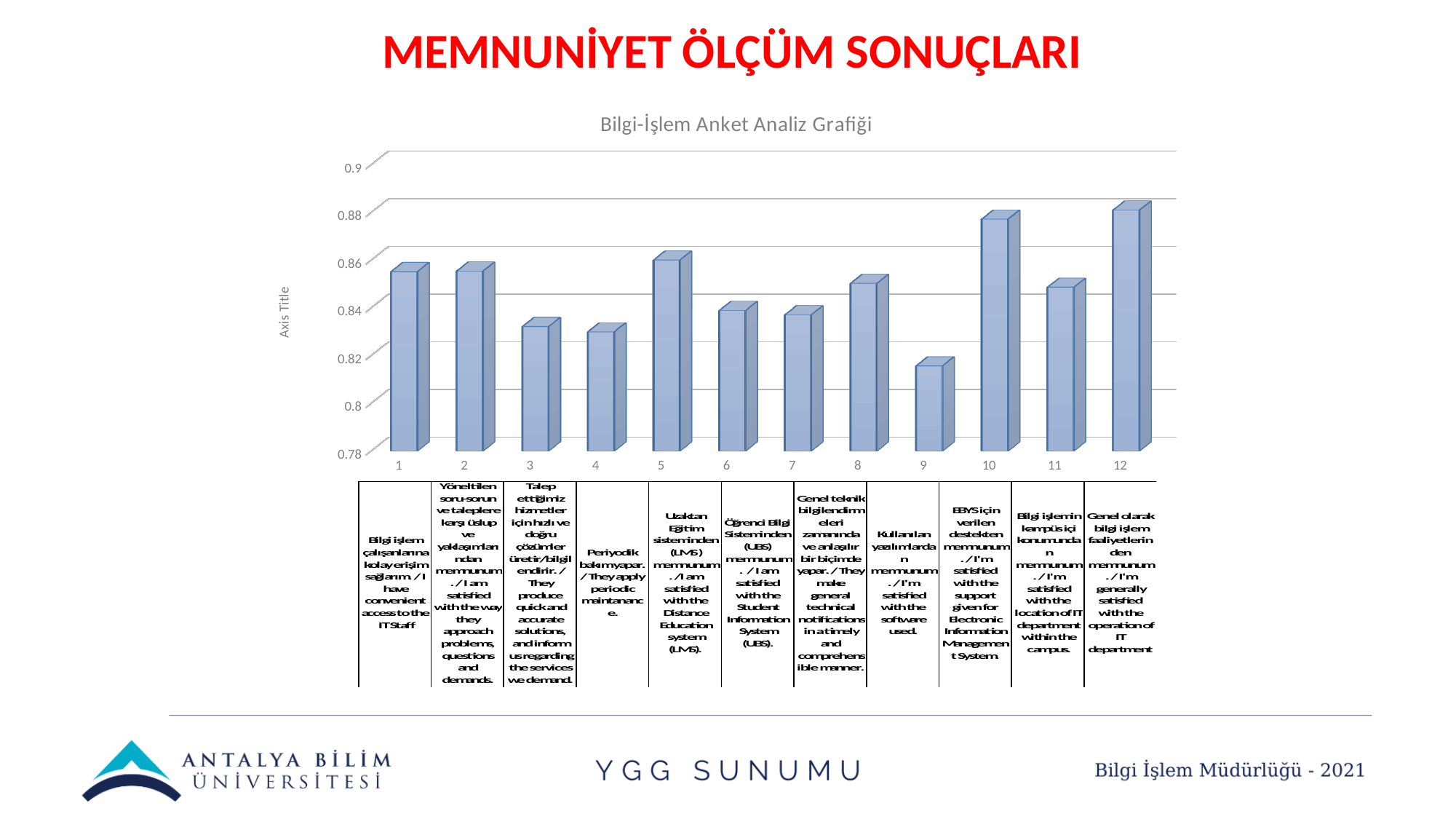
Is the value for category 3 greater or less than 0.84? less What kind of chart is shown on the slide? bar chart What label is shown on the vertical axis of the chart? Axis Title Is the value for category 5 greater or less than 0.84? greater Is the value for category 9 greater or less than 0.82? less How many categories (bars) are plotted in the chart? 12 Which is larger, the value for category 5 or the value for category 4? category 5 Which is larger, the value for category 8 or the value for category 9? category 8 Which category has the lowest bar in the chart? 9 What is the title of the chart? Bilgi-İşlem Anket Analiz Grafiği